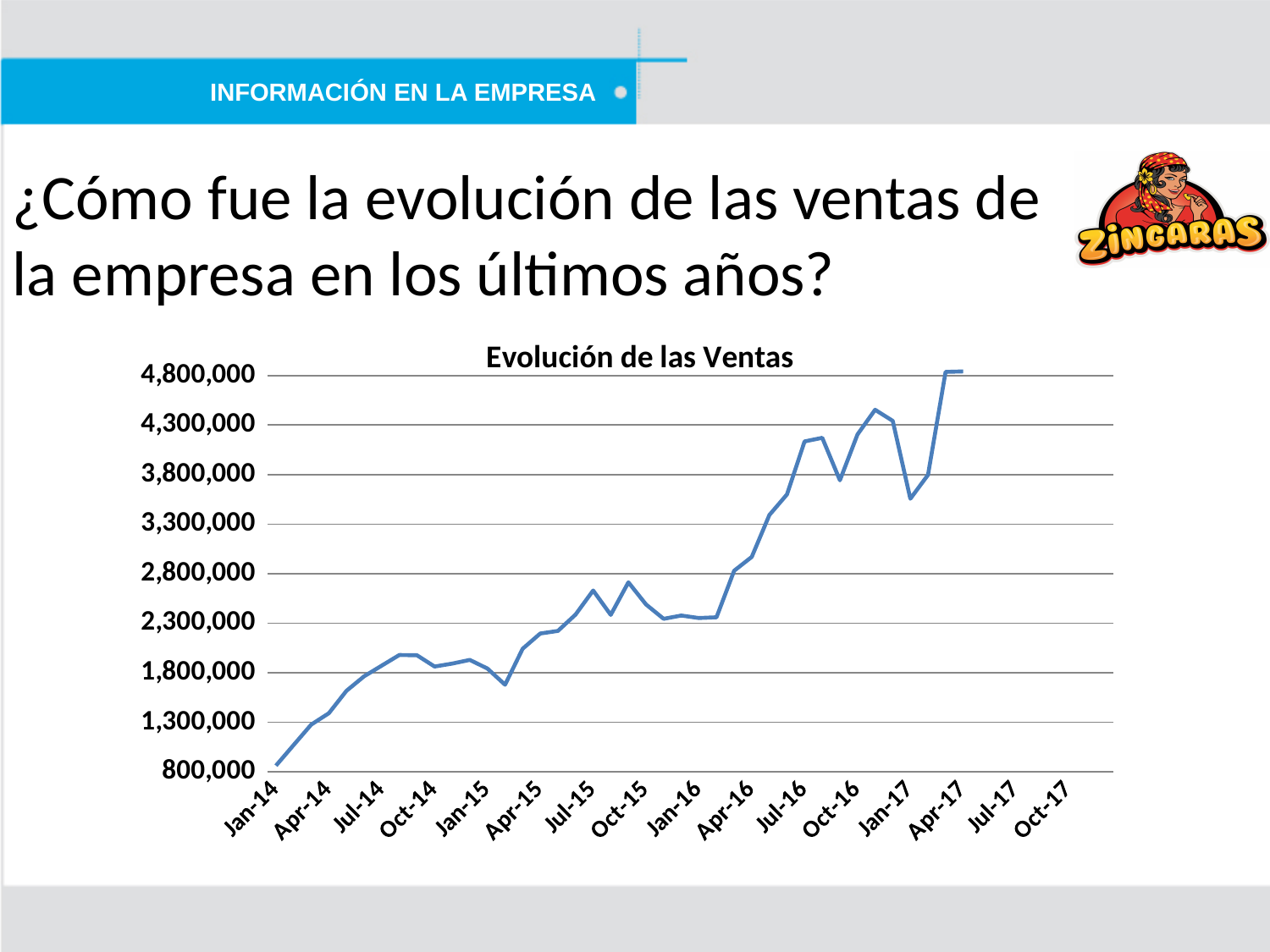
What is the highest value shown on the y axis? 4,800,000 What kind of chart is shown on the slide? line chart Is the value for Apr-15 greater or less than 2,300,000? less Overall, do the sales values rise or fall from Jan-14 to Apr-17? rise Is the value for Jan-16 greater or less than 2,800,000? less What is the title of the chart? Evolución de las Ventas Is the value for Apr-17 greater or less than 4,300,000? greater How many month labels are shown on the x axis? 16 Which month label on the x axis has the lowest sales value? Jan-14 Which is larger, the value for Jul-16 or the value for Jul-15? Jul-16